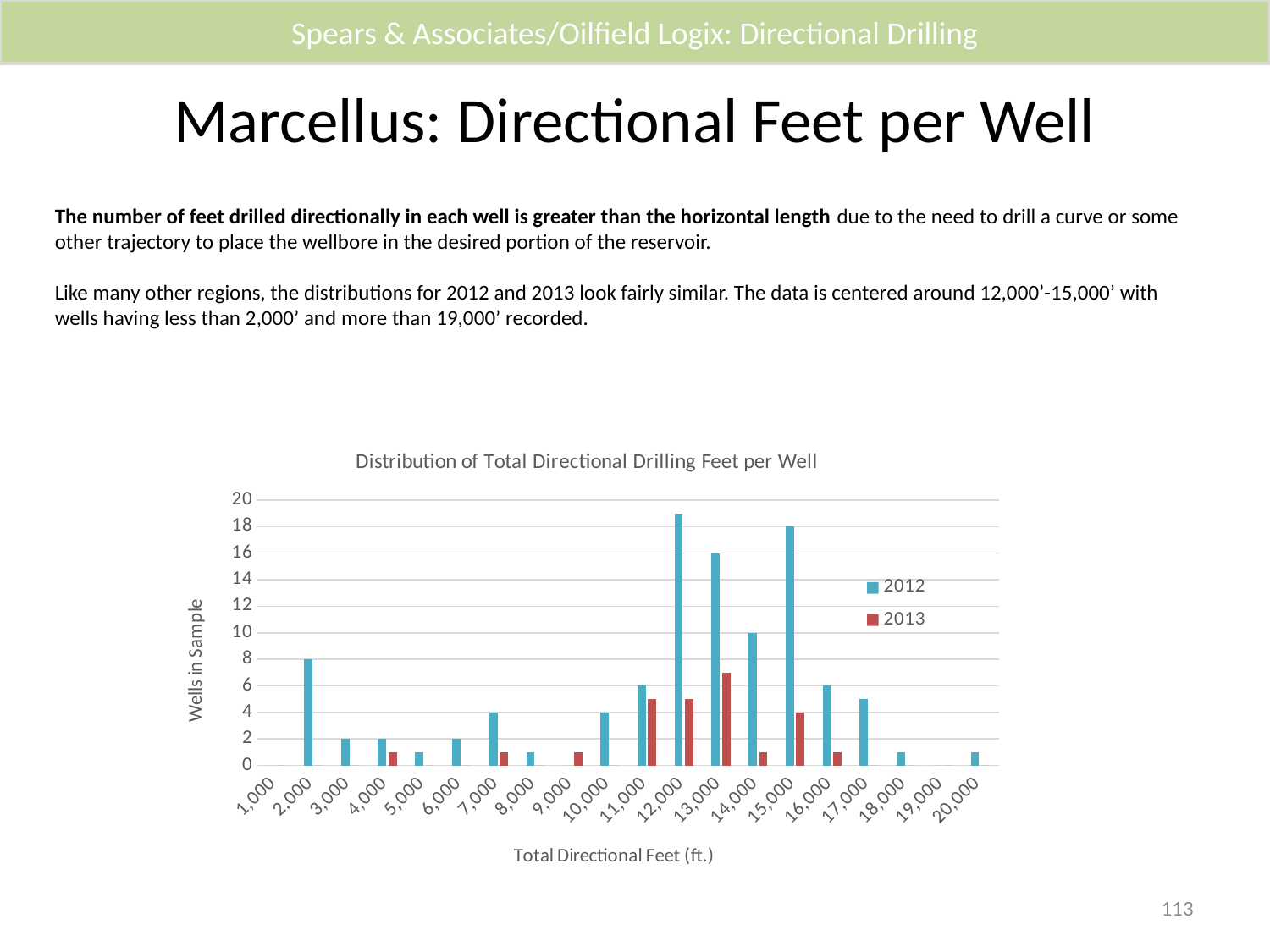
How many categories are shown on the x axis? 20 How many series does the legend list? 2 What is the difference between the 2012 and 2013 values for the 15,000 ft category? 14 What is the title of the chart? Distribution of Total Directional Drilling Feet per Well What is the 2012 value for the 15,000 ft category? 18 How many wells in the 2012 series fall in the 2,000 ft category? 8 What is the 2012 value for the 13,000 ft category? 16 Is the 2012 value for the 12,000 ft category greater or less than 18? greater What is the 2013 value for the 15,000 ft category? 4 What kind of chart is shown on the slide? bar chart Which category has the highest 2013 value? 13,000 Which category has the highest 2012 value? 12,000